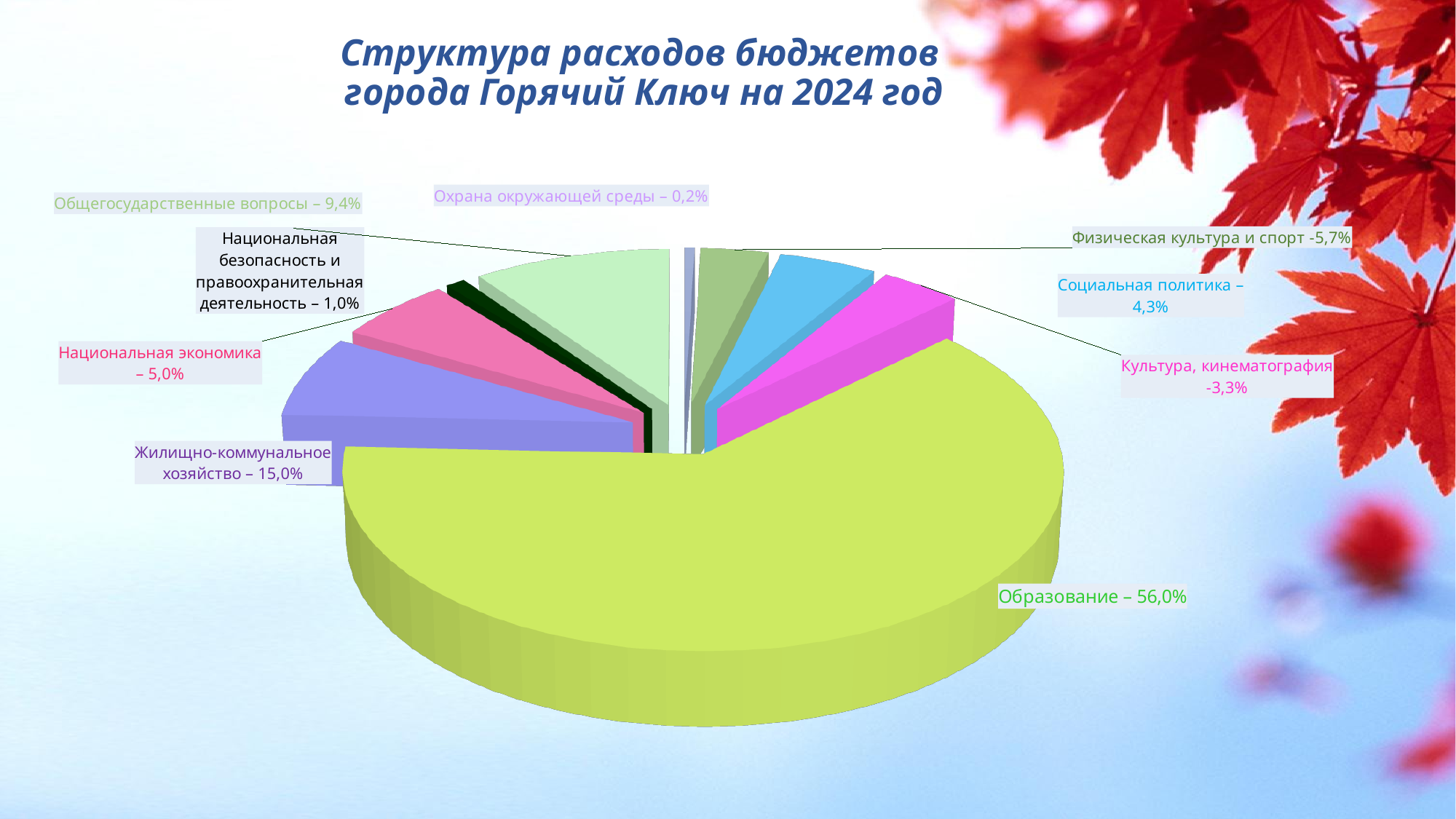
What is the difference between the shares of Национальная экономика and Культура, кинематография? 1,7% How many categories are shown in the pie chart? 9 What share of the budget expenditure goes to Образование? 56,0% Which category has the smallest share of the budget? Охрана окружающей среды What is the value for Общегосударственные вопросы? 9,4% Which category has the largest share of the budget? Образование What is the title of the chart? Структура расходов бюджетов города Горячий Ключ на 2024 год Which is larger: Физическая культура и спорт or Социальная политика? Физическая культура и спорт What is the value for Жилищно-коммунальное хозяйство? 15,0% What is the difference between the shares of Образование and Жилищно-коммунальное хозяйство? 41,0% What kind of chart is shown on the slide? Pie chart What is the value for Охрана окружающей среды? 0,2%